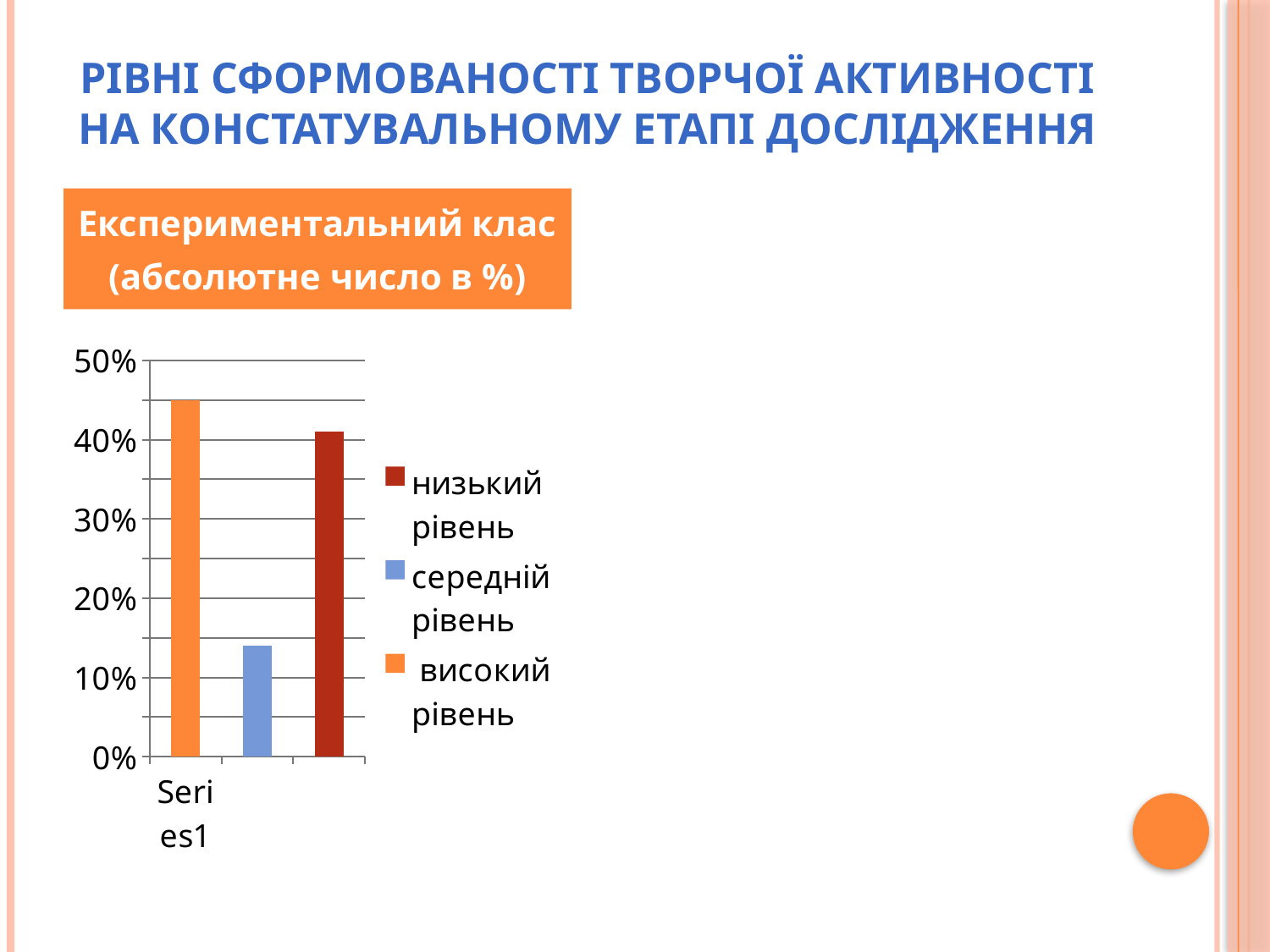
Is the value for середній рівень greater or less than 20%? less Which is larger, the value for низький рівень or the value for середній рівень? низький рівень Is the value for низький рівень greater or less than 50%? less What is the label shown on the category axis of the chart? Series1 What kind of chart is shown on the slide? bar chart How many series does the legend list? 3 How many bars are plotted in the chart? 3 Which level has the highest bar in the chart? високий рівень Is the value for високий рівень greater or less than 40%? greater Which level has the lowest bar in the chart? середній рівень What colour is the bar for високий рівень? orange